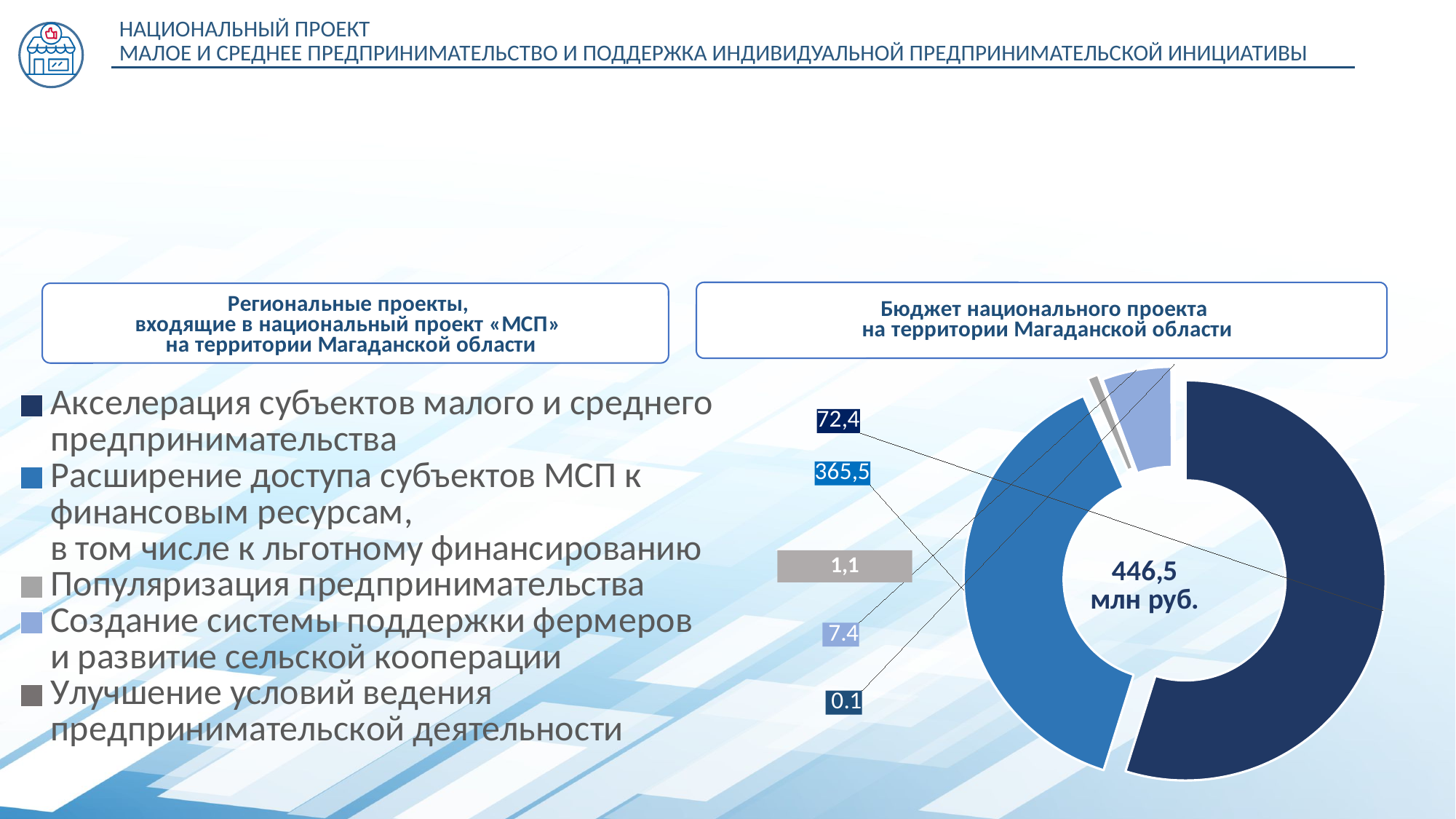
What value is shown for «Улучшение условий ведения предпринимательской деятельности» in the budget chart? 0.1 What value is shown for «Создание системы поддержки фермеров и развитие сельской кооперации» in the budget chart? 7.4 What kind of chart is used to show the national project budget? Doughnut (pie) chart What value is shown for «Акселерация субъектов малого и среднего предпринимательства» in the budget chart? 72,4 What total is shown in the centre of the budget chart? 446,5 млн руб. What value is shown for «Расширение доступа субъектов МСП к финансовым ресурсам, в том числе к льготному финансированию» in the budget chart? 365,5 Which is larger: the value for «Создание системы поддержки фермеров и развитие сельской кооперации» or for «Популяризация предпринимательства»? Создание системы поддержки фермеров и развитие сельской кооперации What is the difference between the values for «Расширение доступа субъектов МСП к финансовым ресурсам» and «Акселерация субъектов малого и среднего предпринимательства»? 293,1 How many segments does the budget chart have? 5 Which regional project has the smallest budget value in the chart? Улучшение условий ведения предпринимательской деятельности Which regional project has the largest budget value in the chart? Расширение доступа субъектов МСП к финансовым ресурсам, в том числе к льготному финансированию What value is shown for «Популяризация предпринимательства» in the budget chart? 1,1